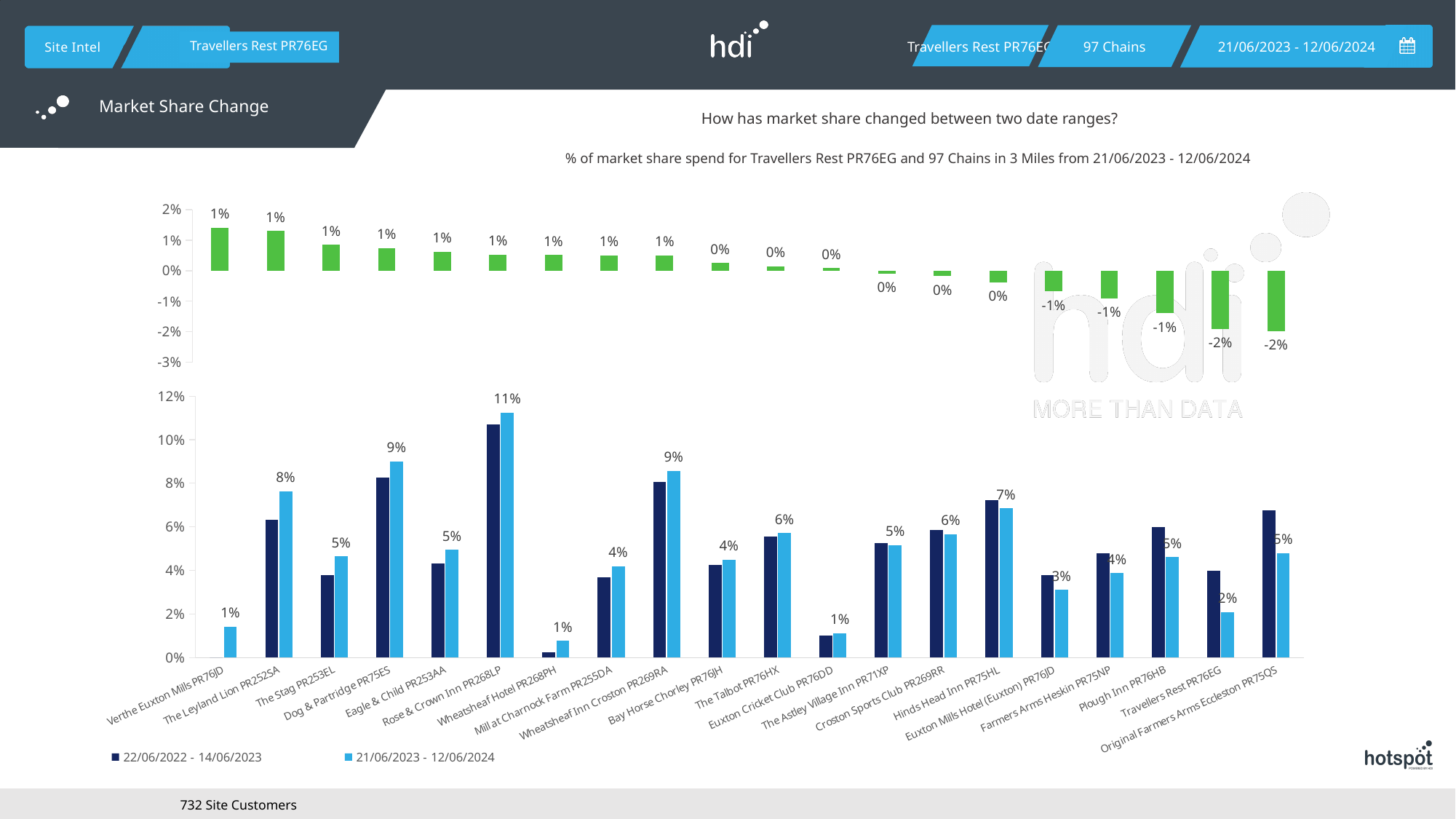
In the bottom chart, which is larger for the 21/06/2023 - 12/06/2024 period: The Leyland Lion PR252SA or The Stag PR253EL? The Leyland Lion PR252SA In the bottom chart, what is the market share for The Leyland Lion PR252SA in the 21/06/2023 - 12/06/2024 period? 8% In the bottom chart, what is the difference between Rose & Crown Inn PR268LP and Dog & Partridge PR75ES in the 21/06/2023 - 12/06/2024 period? 2% In the bottom chart, is the 22/06/2022 - 14/06/2023 value for Rose & Crown Inn PR268LP greater or less than 10%? greater In the bottom chart, how many series does the legend list? 2 In the top chart (market share change), do the values rise or fall from left to right? fall In the bottom chart, which venue has the highest market share in the 21/06/2023 - 12/06/2024 period? Rose & Crown Inn PR268LP In the bottom chart, is the 22/06/2022 - 14/06/2023 value for Hinds Head Inn PR75HL greater or less than 6%? greater In the bottom chart, how many venues are shown on the x axis? 20 In the bottom chart, what is the market share for Rose & Crown Inn PR268LP in the 21/06/2023 - 12/06/2024 period? 11% What kind of chart is the bottom chart? Bar chart